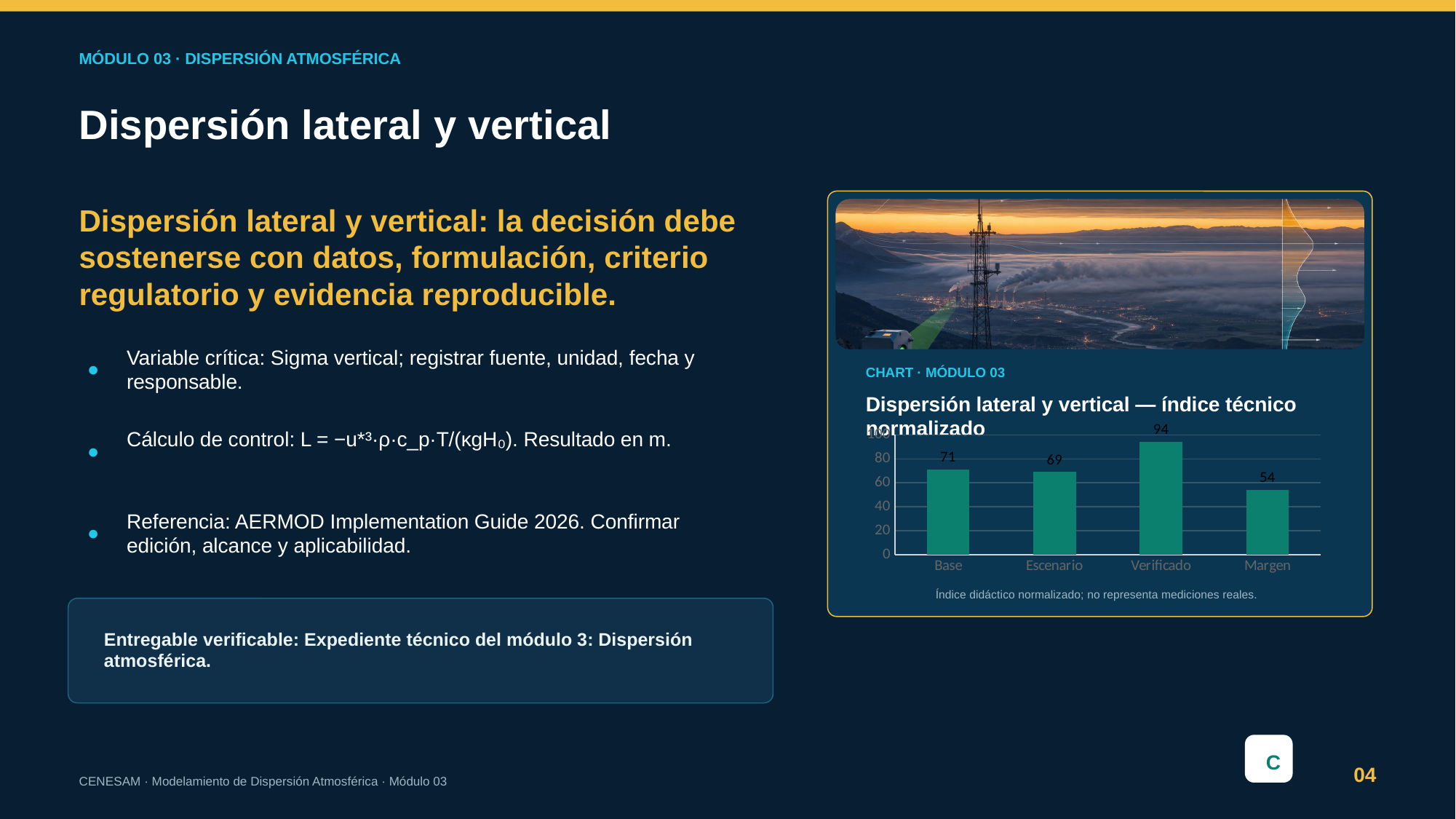
What kind of chart is shown? bar chart What is the value for Margen? 54 Is the value for Margen greater or less than 60? less How many categories are shown on the x axis? 4 What is the value for Verificado? 94 What is the value for Base? 71 What is the difference between the values for Base and Escenario? 2 Which category has the lowest value? Margen What is the value for Escenario? 69 Which category has the highest value? Verificado What is the difference between the values for Verificado and Margen? 40 Which is larger, the value for Verificado or the value for Base? Verificado